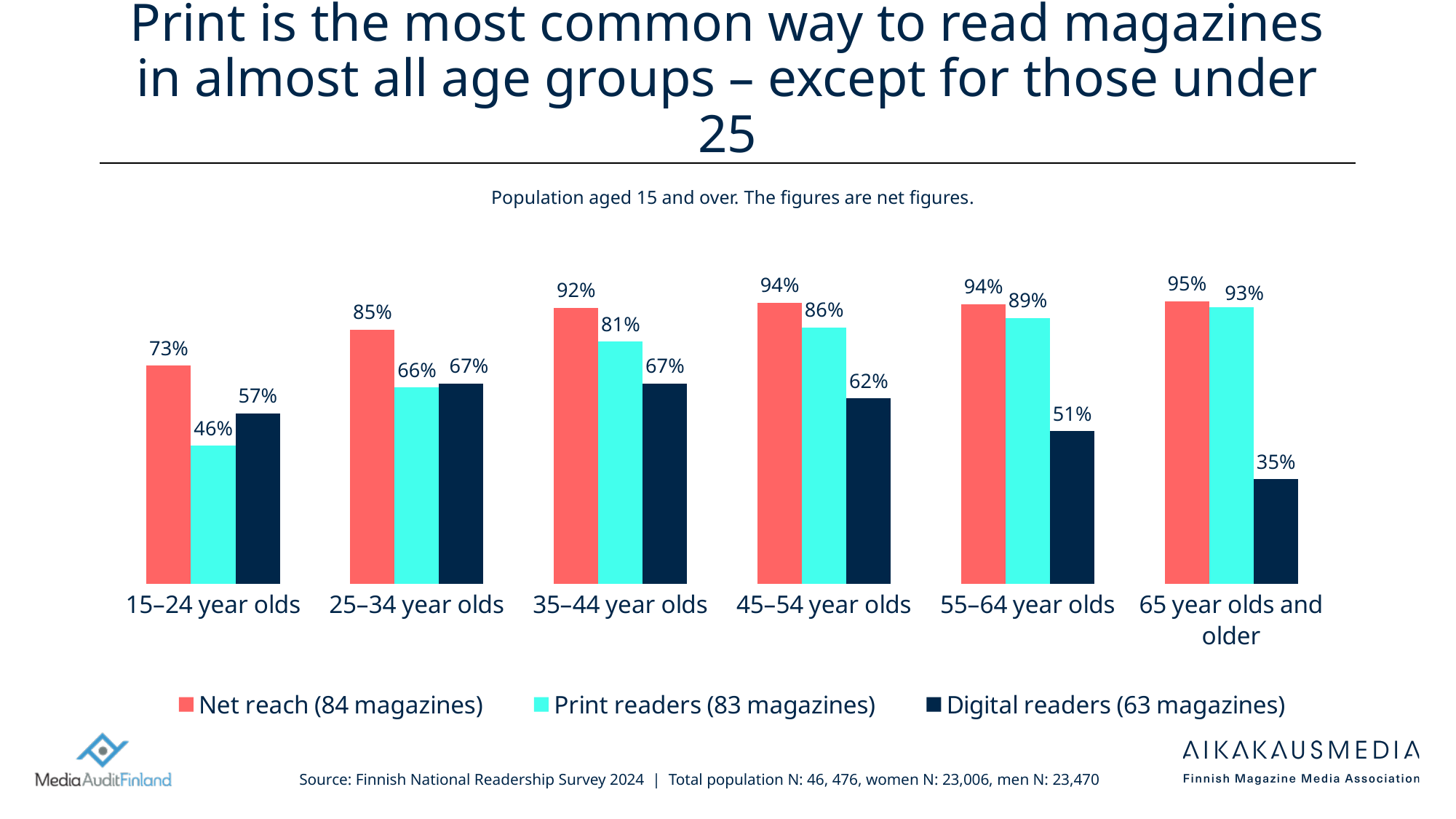
Do the Digital readers values rise or fall from 35–44 year olds to 65 year olds and older? Fall Which age group has the lowest Digital readers value? 65 year olds and older Which age group has the highest Net reach? 65 year olds and older How many age groups are shown on the x axis? 6 How many series does the legend list? 3 What is the difference between Print readers and Digital readers for 55–64 year olds? 38% What is the Net reach value for 35–44 year olds? 92% How many magazines are included in the Print readers series according to the legend? 83 magazines What is the Digital readers value for 65 year olds and older? 35% What is the Print readers value for 15–24 year olds? 46% For 15–24 year olds, which is larger: Print readers or Digital readers? Digital readers What kind of chart is shown on the slide? Bar chart